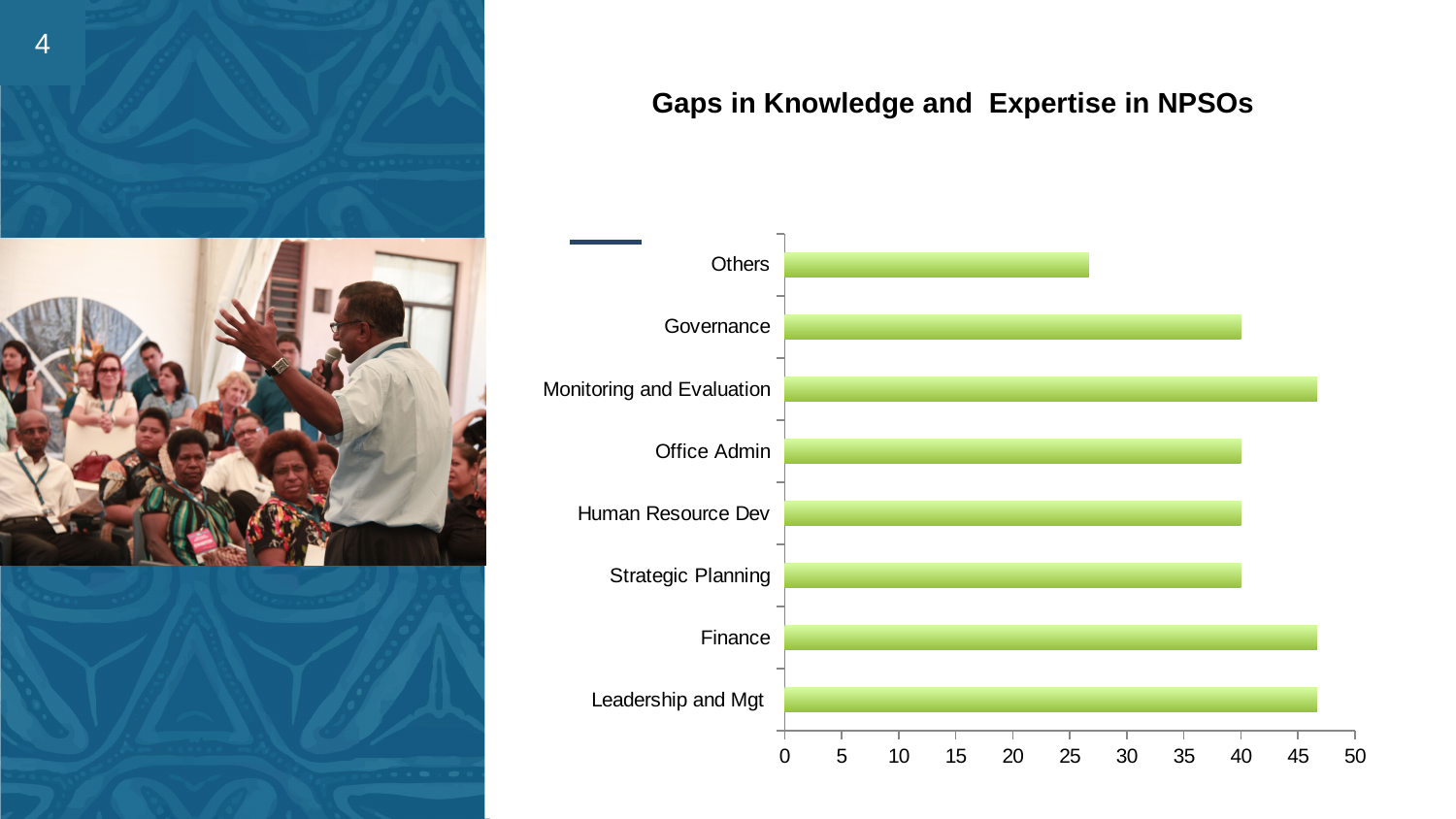
What is the highest value shown on the horizontal axis? 50 Which is larger, the value for Finance or the value for Office Admin? Finance How many categories are plotted in the chart? 8 Is the value for Others greater or less than 30? less Is the value for Leadership and Mgt greater or less than 40? greater Is the value for Monitoring and Evaluation greater or less than 45? greater Which category has the lowest value? Others Which is larger, the value for Governance or the value for Others? Governance What kind of chart is shown on the slide? bar chart What is the title of the chart? Gaps in Knowledge and Expertise in NPSOs